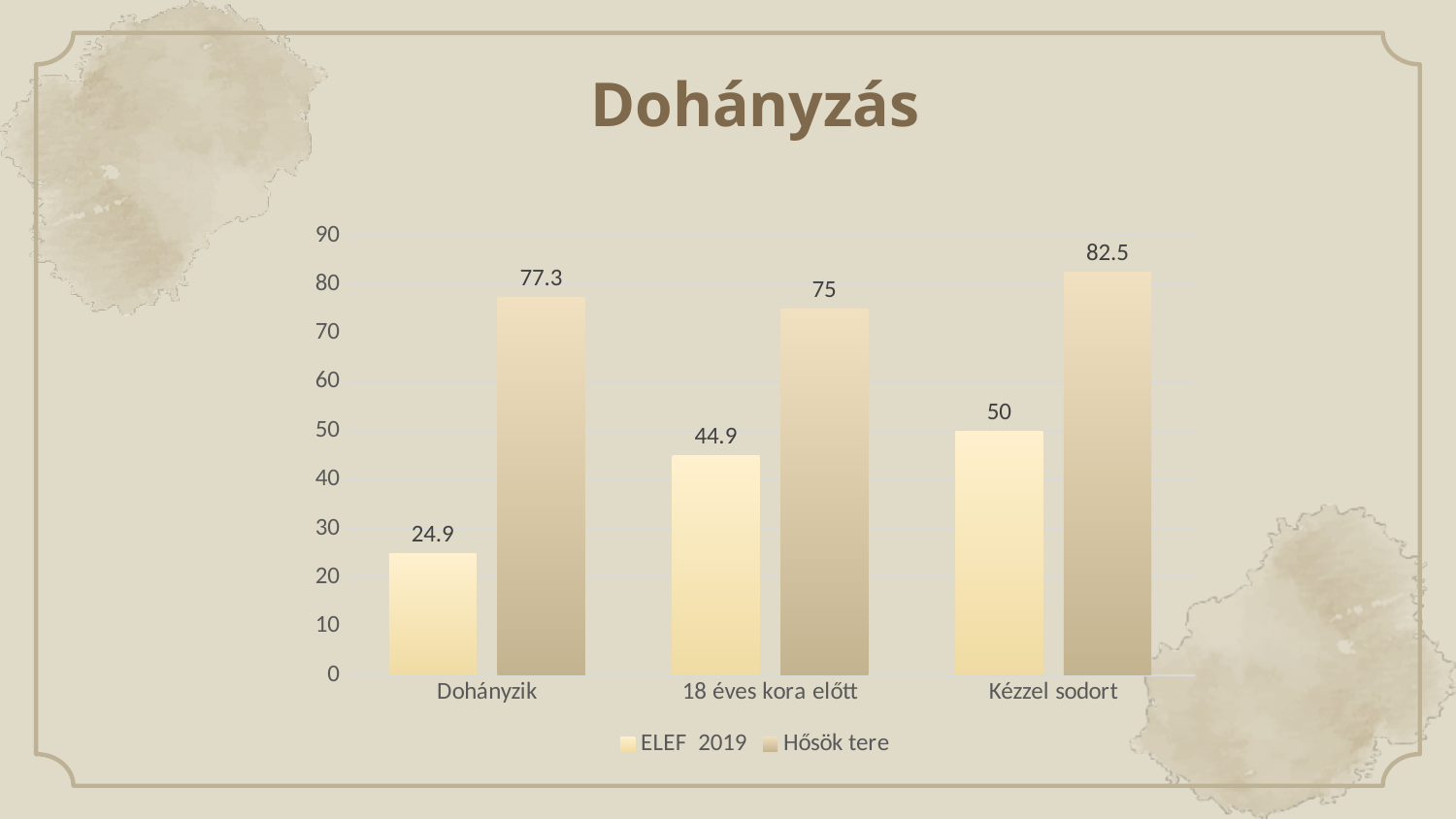
How many series does the legend list? 2 Which is larger in the 18 éves kora előtt category: ELEF 2019 or Hősök tere? Hősök tere What kind of chart is shown on the slide? Bar chart What is the value for Hősök tere in the Kézzel sodort category? 82.5 What is the title of the slide? Dohányzás What is the value for ELEF 2019 in the Dohányzik category? 24.9 Which category has the highest value for the Hősök tere series? Kézzel sodort What is the difference between the Hősök tere and ELEF 2019 values in the Dohányzik category? 52.4 Which category has the lowest value for the ELEF 2019 series? Dohányzik What is the value for ELEF 2019 in the Kézzel sodort category? 50 What is the value for Hősök tere in the 18 éves kora előtt category? 75 How many categories are shown on the x axis? 3